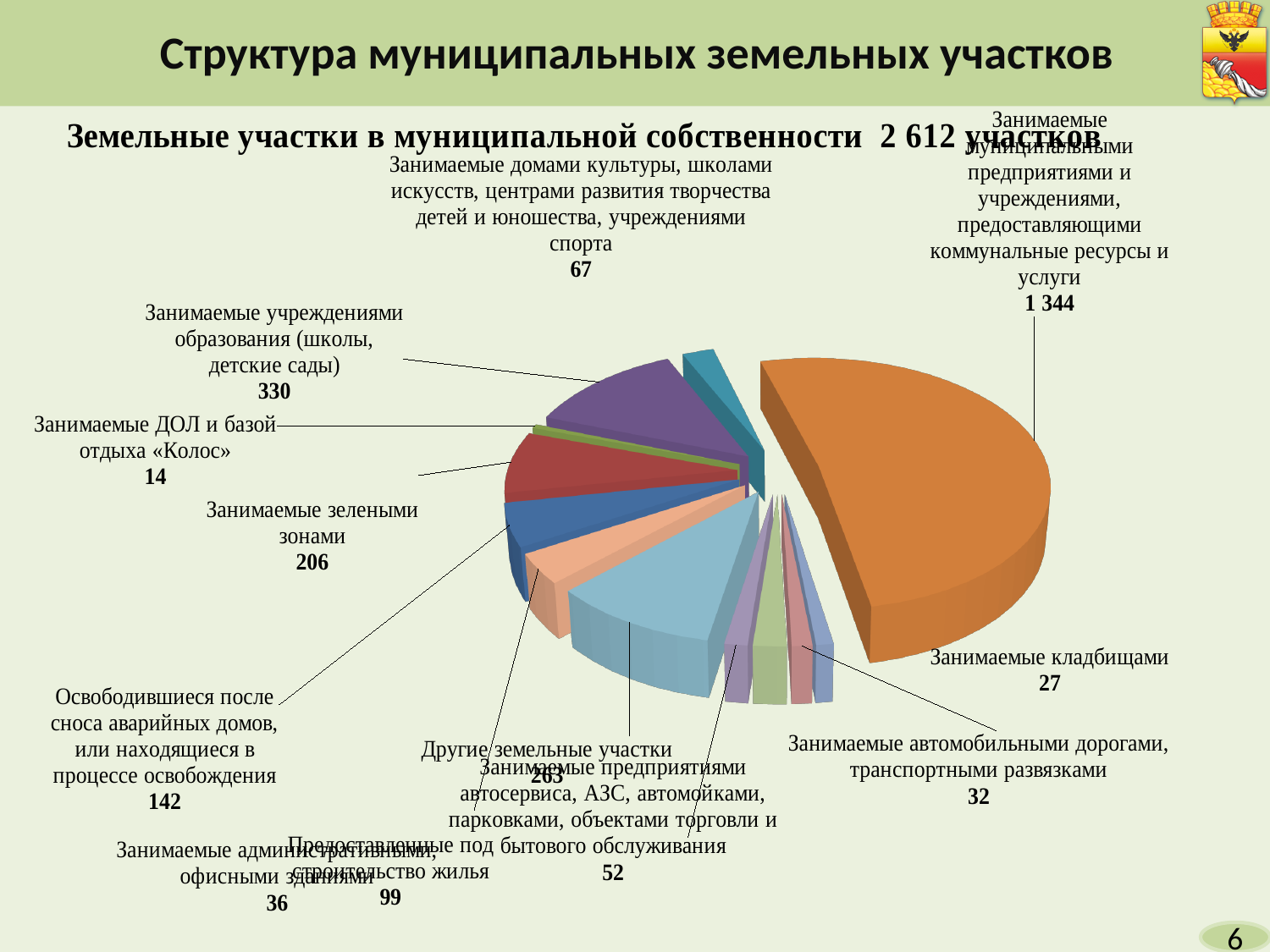
How many categories does the pie chart contain? 12 How many land plots are occupied by municipal enterprises and institutions providing communal resources and services (Занимаемые муниципальными предприятиями и учреждениями, предоставляющими коммунальные ресурсы и услуги)? 1 344 What type of chart is shown on the slide? pie chart What is the value for 'Другие земельные участки'? 263 What total number of land plots in municipal ownership is stated in the chart heading? 2 612 Which is larger: plots freed after demolition of emergency houses (Освободившиеся после сноса аварийных домов) or plots provided for housing construction (Предоставленные под строительство жилья)? Освободившиеся после сноса аварийных домов What is the difference between the plots occupied by educational institutions (330) and the plots occupied by green zones (206)? 124 What is the value for plots occupied by educational institutions (Занимаемые учреждениями образования (школы, детские сады))? 330 What is the value for plots occupied by cemeteries (Занимаемые кладбищами)? 27 What is the value for plots occupied by green zones (Занимаемые зелеными зонами)? 206 Which category has the largest slice of the pie? Занимаемые муниципальными предприятиями и учреждениями, предоставляющими коммунальные ресурсы и услуги Which category has the smallest value in the chart? Занимаемые ДОЛ и базой отдыха «Колос»